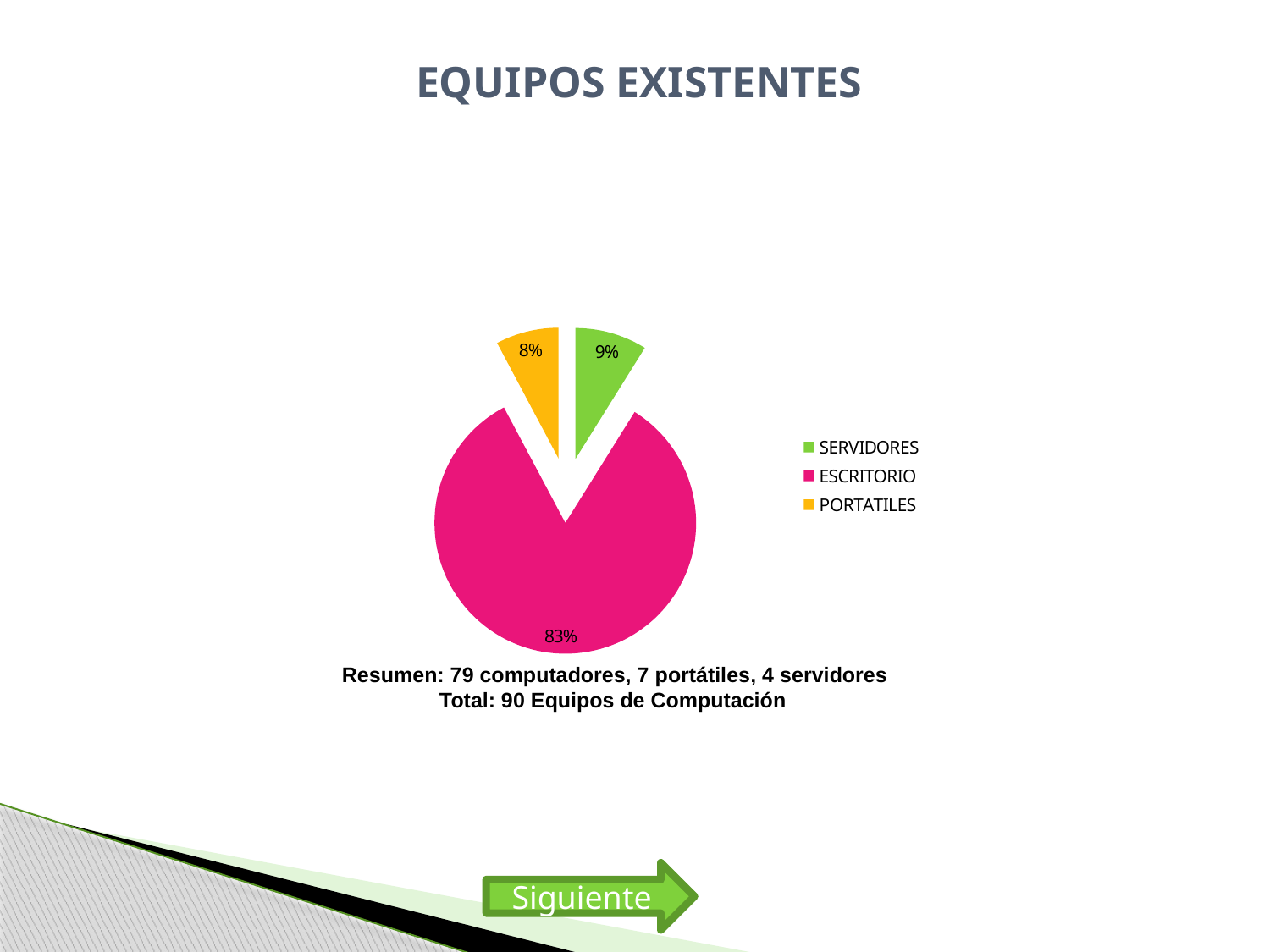
How many categories does the pie chart show? 3 Which slice is larger, SERVIDORES or PORTATILES? SERVIDORES How many entries does the legend list? 3 What is the difference in percentage points between the ESCRITORIO slice and the SERVIDORES slice? 74 What percentage of the pie does SERVIDORES represent? 9% What percentage of the pie does ESCRITORIO represent? 83% What percentage of the pie does PORTATILES represent? 8% What kind of chart is shown on the slide? Pie chart What colour is the ESCRITORIO slice in the pie chart? Magenta (pink) Which category has the smallest slice of the pie? PORTATILES Which category has the largest slice of the pie? ESCRITORIO What is the title of the slide containing the pie chart? EQUIPOS EXISTENTES